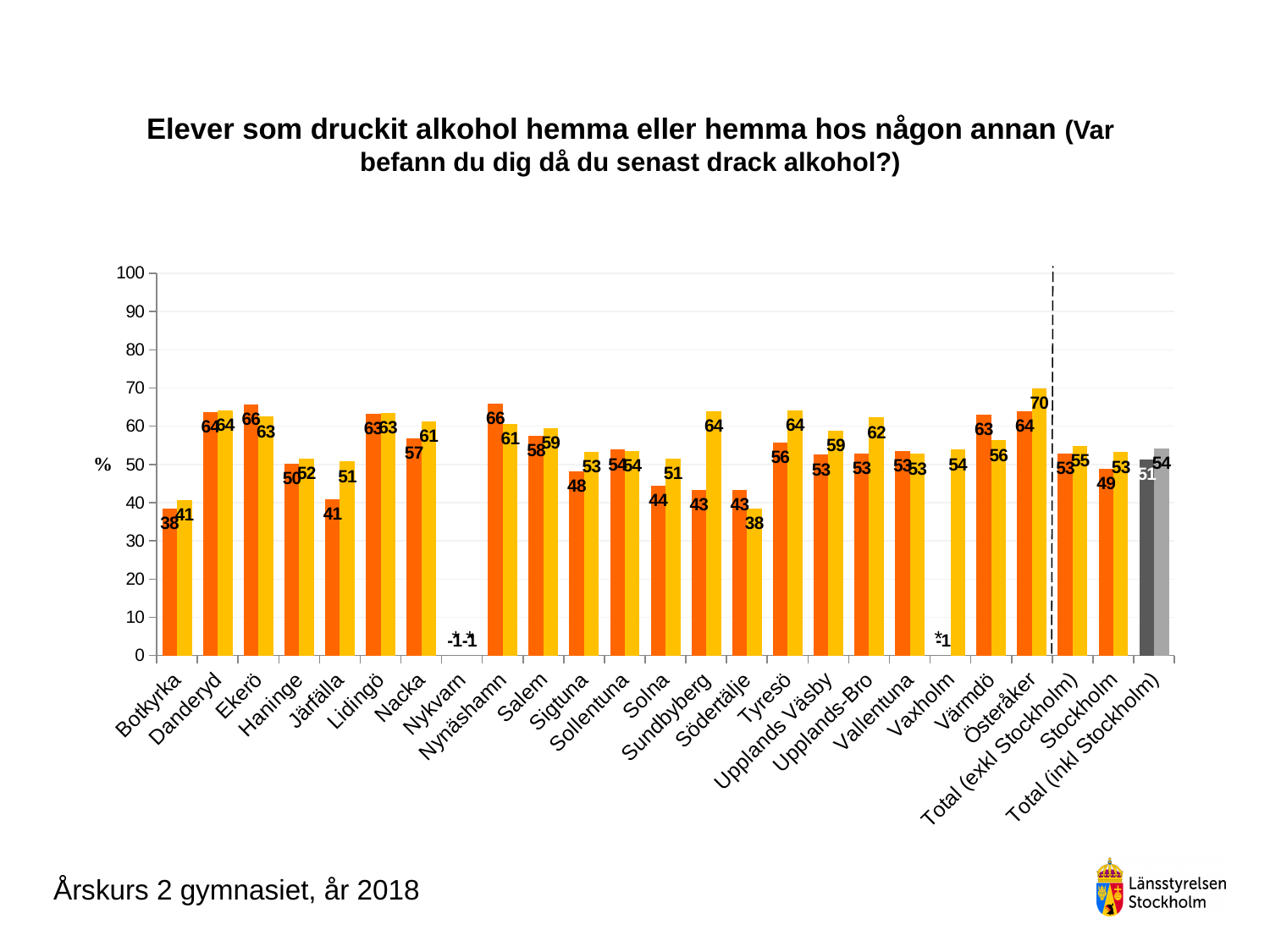
What is the value of the light grey bar for Total (inkl Stockholm)? 54 Which municipality has the lowest yellow bar (excluding Nykvarn, which has no data)? Södertälje What is the value of the yellow bar for Sundbyberg? 64 What type of chart is shown on the slide? bar chart For Värmdö, which bar is larger, the orange or the yellow one? orange Which municipality has the highest yellow bar? Österåker What is the value of the yellow bar for Österåker? 70 What is the difference between the yellow and orange bars for Sundbyberg? 21 What is the difference between the orange bars for Ekerö and Järfälla? 25 What is the value of the orange bar for Botkyrka? 38 What is the unit label shown on the y axis? % How many categories are shown along the x axis? 25